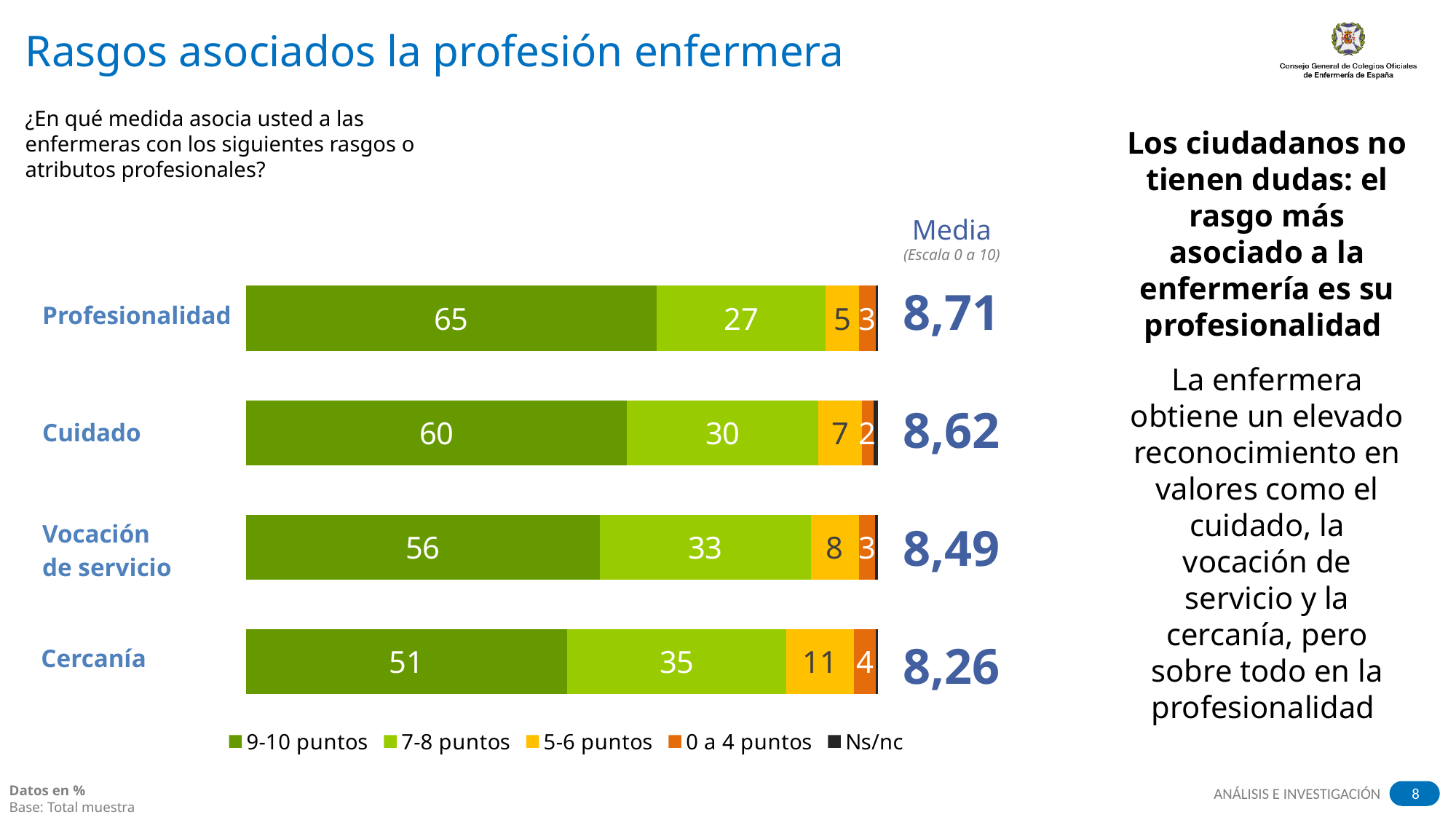
What is the difference between the 9-10 puntos values for Profesionalidad and Cercanía? 14 What percentage of respondents gave 9-10 puntos for Profesionalidad? 65 Which legend entry is represented by the dark green colour? 9-10 puntos Which attribute has the highest Media value? Profesionalidad Which attribute has the lowest share of 9-10 puntos? Cercanía What kind of chart is shown on the slide? Stacked bar chart What is the 5-6 puntos value for Vocación de servicio? 8 How many series does the legend list? 5 What is the 7-8 puntos value for Cercanía? 35 How many attributes (categories) are shown in the chart? 4 What is the Media (mean score) shown for Cuidado? 8,62 Which is larger: the 7-8 puntos value for Cuidado or for Vocación de servicio? Vocación de servicio